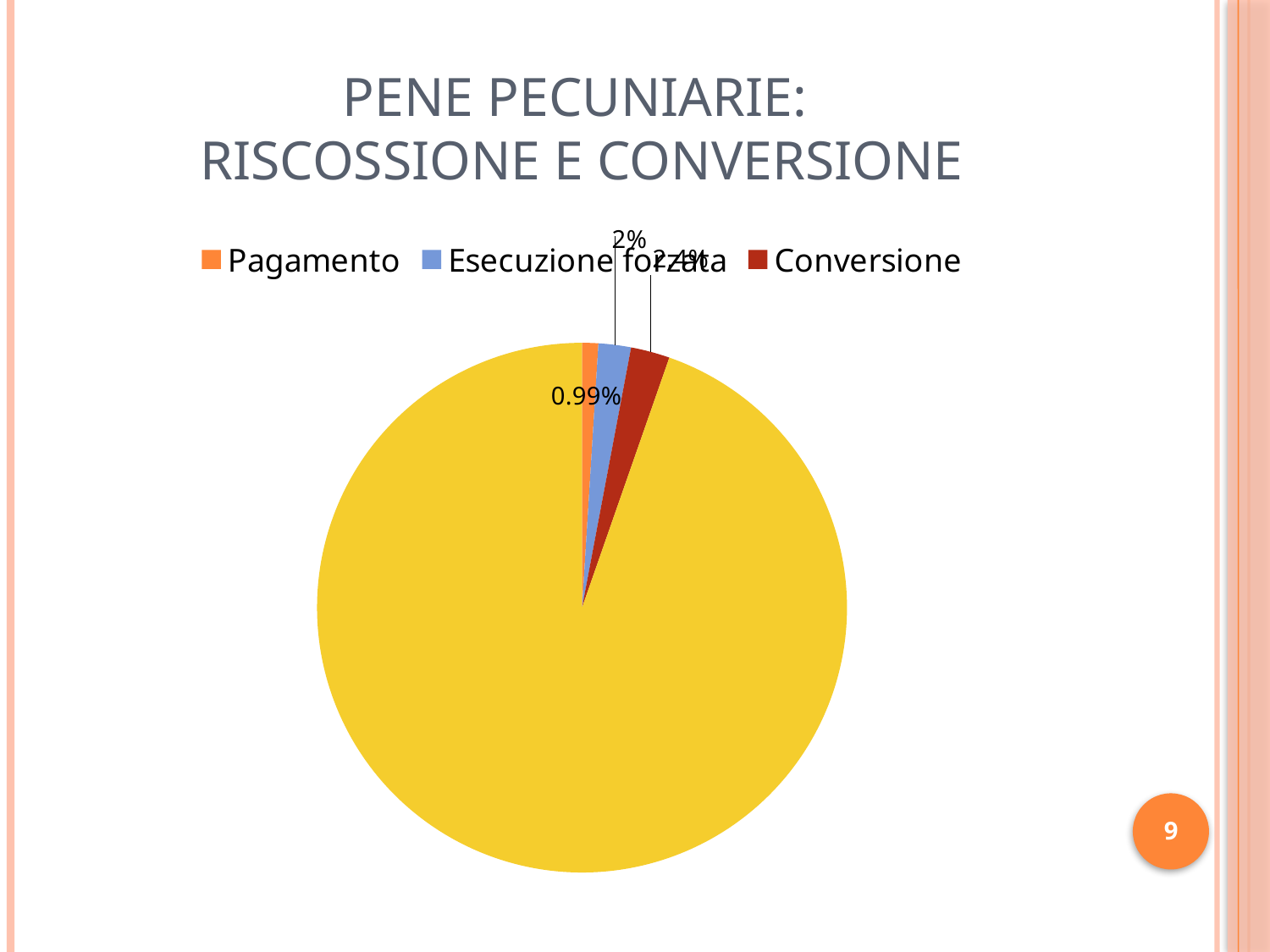
Which of the legend categories has the smallest slice in the pie chart? Pagamento What percentage is shown for the Esecuzione forzata slice? 2% How many entries does the legend of the pie chart list? 3 What percentage is shown for the Pagamento slice? 0.99% Is the share of the large yellow slice greater or less than 50%? greater What is the title of the slide containing the pie chart? PENE PECUNIARIE: RISCOSSIONE E CONVERSIONE What kind of chart is shown on the slide? pie chart How many slices does the pie chart have? 4 What is the difference between the Esecuzione forzata share and the Pagamento share? 1.01% What colour represents Conversione in the pie chart legend? dark red Which slice is larger, Pagamento or Esecuzione forzata? Esecuzione forzata